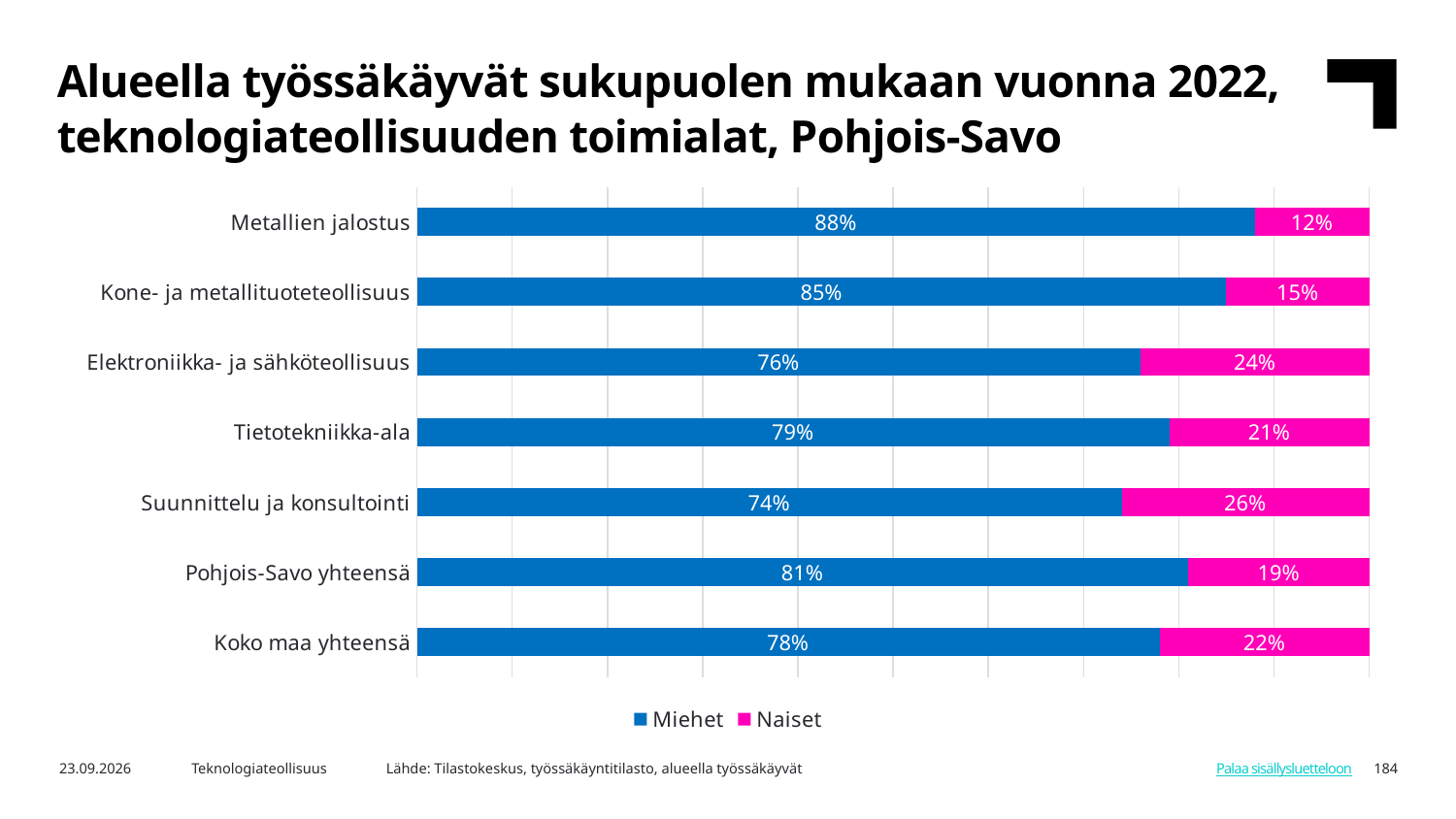
What is the Miehet share for Koko maa yhteensä? 78% What kind of chart is shown on the slide? Stacked bar chart What is the Naiset share for Pohjois-Savo yhteensä? 19% What is the Miehet share for Metallien jalostus? 88% Which is larger: the Naiset share for Elektroniikka- ja sähköteollisuus or for Tietotekniikka-ala? Elektroniikka- ja sähköteollisuus Which category has the highest Naiset share? Suunnittelu ja konsultointi Which category has the lowest Miehet share? Suunnittelu ja konsultointi How many categories are shown on the chart? 7 What is the difference between the Miehet share for Metallien jalostus and for Tietotekniikka-ala? 9 percentage points How many series does the legend list? 2 What is the Naiset share for Suunnittelu ja konsultointi? 26% What is the total of the stacked bar for Kone- ja metallituoteteollisuus? 100%